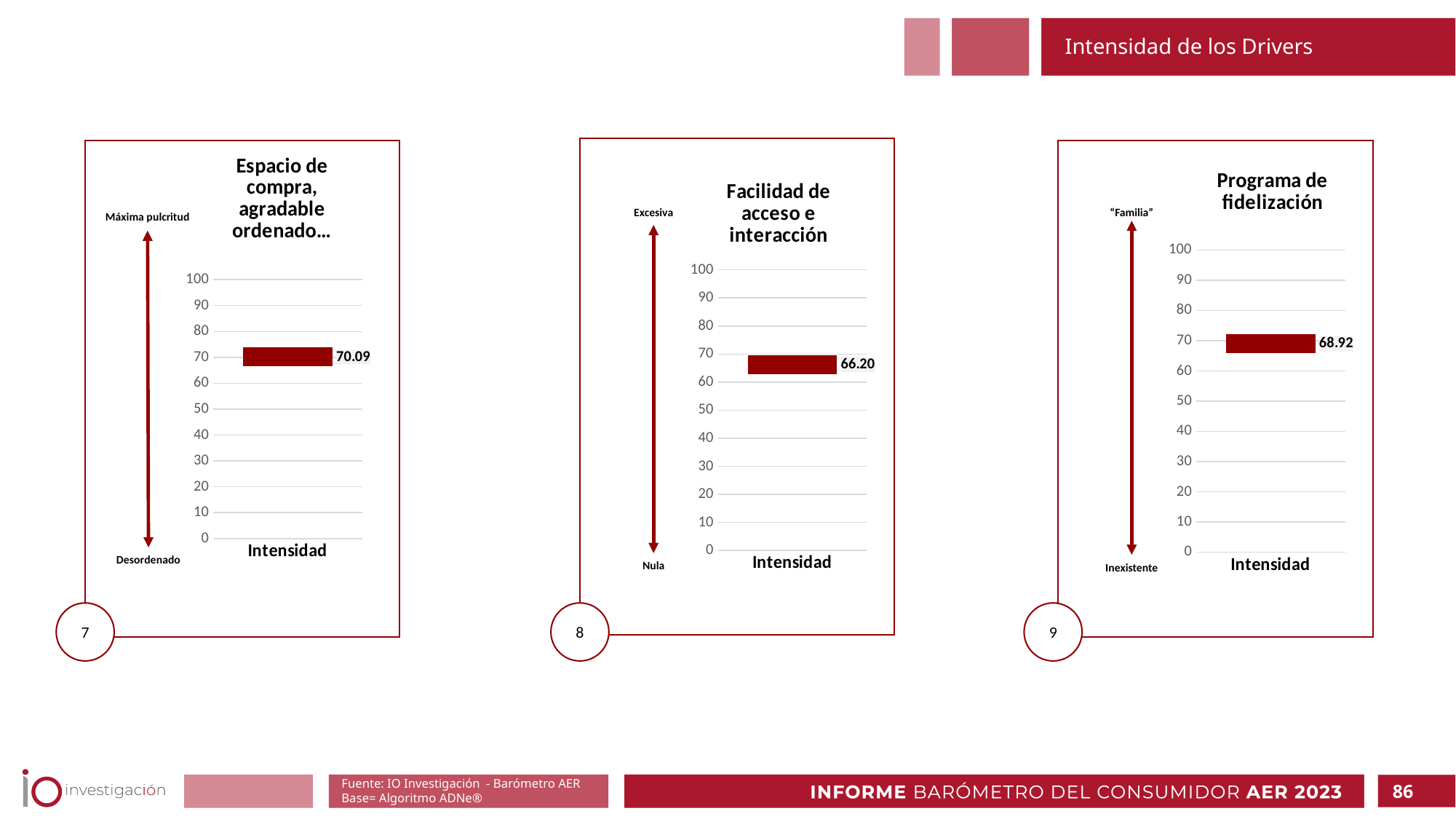
In the "Espacio de compra, agradable ordenado…" chart, is the Intensidad value greater or less than 60? greater How many bars are plotted in the "Facilidad de acceso e interacción" chart? 1 Which is larger: the Intensidad value in the "Espacio de compra, agradable ordenado…" chart or in the "Facilidad de acceso e interacción" chart? Espacio de compra, agradable ordenado… What is the difference between the Intensidad value in the "Programa de fidelización" chart and the one in the "Facilidad de acceso e interacción" chart? 2.72 What kind of chart is the "Programa de fidelización" chart? Bar chart In the chart titled "Espacio de compra, agradable ordenado…", what is the value of the Intensidad bar? 70.09 What is the difference between the Intensidad value in the "Espacio de compra, agradable ordenado…" chart and the one in the "Facilidad de acceso e interacción" chart? 3.89 In the "Facilidad de acceso e interacción" chart, is the Intensidad value greater or less than 70? less In the chart titled "Facilidad de acceso e interacción", what is the value of the Intensidad bar? 66.20 What is the maximum value shown on the vertical axis of the "Programa de fidelización" chart? 100 In the chart titled "Programa de fidelización", what is the value of the Intensidad bar? 68.92 What label appears at the top of the arrow next to the "Espacio de compra, agradable ordenado…" chart? Máxima pulcritud